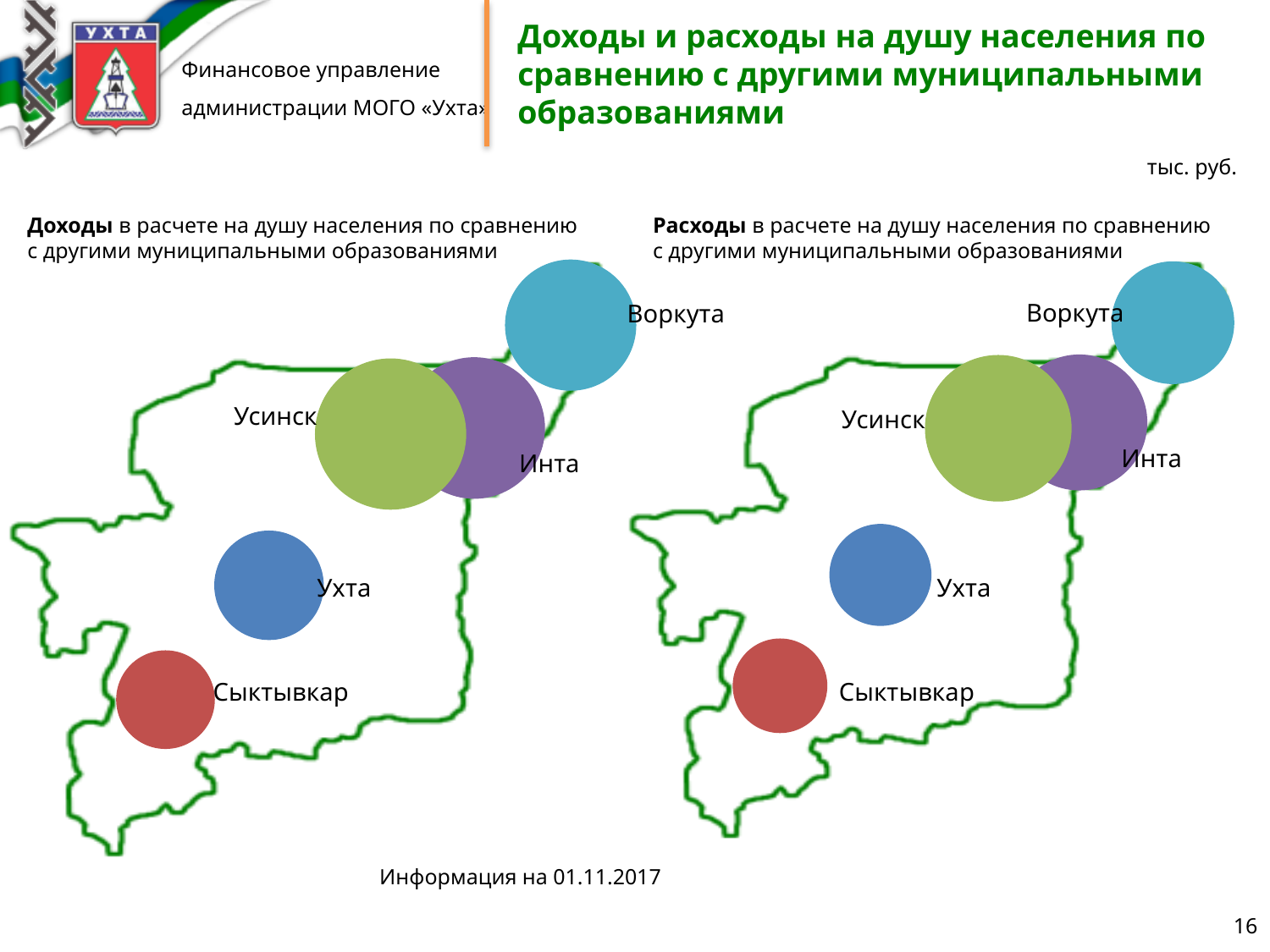
What colour is the bubble for Ухта on the right-hand chart (Расходы в расчете на душу населения)? blue On the right-hand chart (Расходы в расчете на душу населения), which municipality has the largest bubble? Усинск How many municipalities are shown as bubbles on the left-hand chart (Доходы в расчете на душу населения)? 5 On the left-hand chart (Доходы в расчете на душу населения), which municipality has the largest bubble? Усинск On the left-hand chart (Доходы в расчете на душу населения), which bubble is larger, Усинск or Ухта? Усинск What unit of measurement is stated for the charts on the slide? тыс. руб. On the right-hand chart (Расходы в расчете на душу населения), which bubble is larger, Инта or Сыктывкар? Инта On the left-hand chart (Доходы в расчете на душу населения), which bubble is larger, Воркута or Сыктывкар? Воркута What kind of chart is used on the left-hand chart (Доходы в расчете на душу населения)? bubble chart How many municipalities are shown as bubbles on the right-hand chart (Расходы в расчете на душу населения)? 5